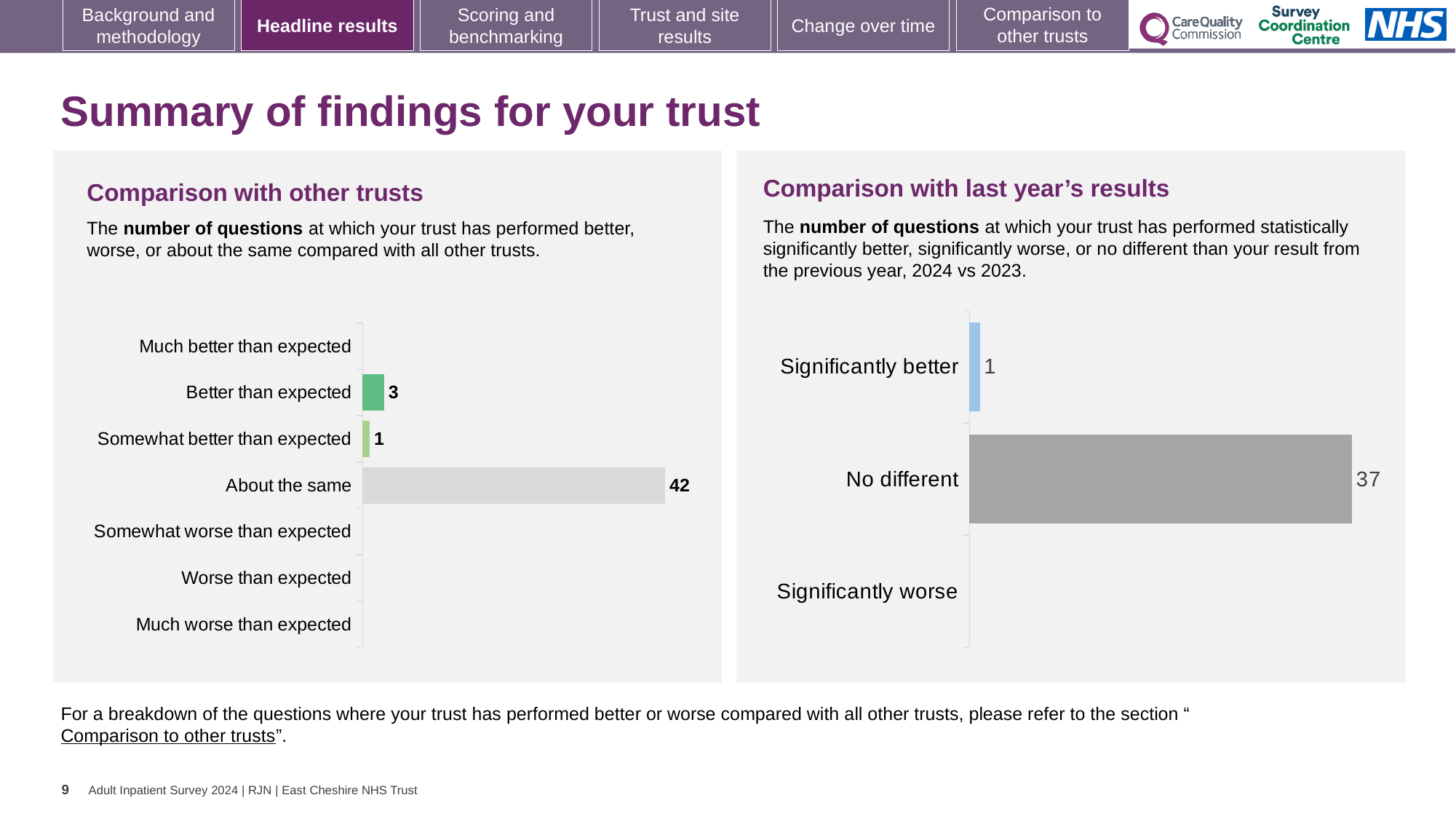
What type of chart is the 'Comparison with other trusts' chart? Bar chart In the 'Comparison with last year's results' chart, what is the difference between 'No different' and 'Significantly better'? 36 In the 'Comparison with other trusts' chart, how many categories are listed on the axis? 7 In the 'Comparison with last year's results' chart, how many questions were 'Significantly better'? 1 In the 'Comparison with other trusts' chart, how many questions were 'Somewhat better than expected'? 1 In the 'Comparison with other trusts' chart, which category has the highest number of questions? About the same In the 'Comparison with last year's results' chart, how many questions were 'No different'? 37 In the 'Comparison with other trusts' chart, how many questions were 'About the same'? 42 In the 'Comparison with last year's results' chart, how many categories are listed on the axis? 3 In the 'Comparison with other trusts' chart, what is the difference between 'About the same' and 'Better than expected'? 39 In the 'Comparison with other trusts' chart, how many questions were 'Better than expected'? 3 In the 'Comparison with last year's results' chart, which category has the highest value? No different